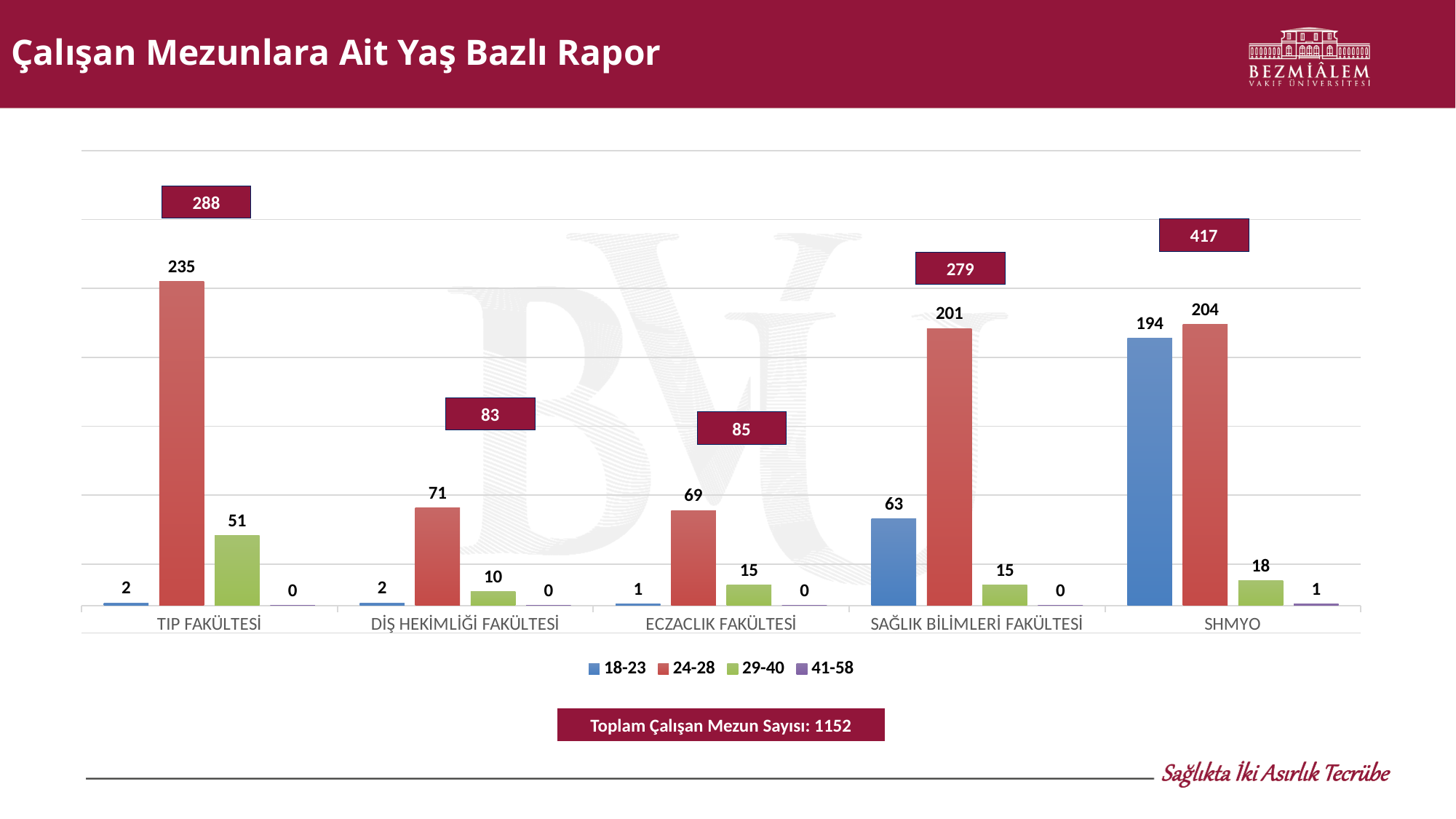
Which category has the highest value for the 24-28 series? TIP FAKÜLTESİ Which category has the lowest value for the 18-23 series? ECZACLIK FAKÜLTESİ What kind of chart is shown on the slide? bar chart What total is shown in the box above the SHMYO group? 417 What is the difference between the 24-28 values for SAĞLIK BİLİMLERİ FAKÜLTESİ and ECZACLIK FAKÜLTESİ? 132 What is the value for the 18-23 series at SHMYO? 194 What is the value for the 41-58 series at SHMYO? 1 What is the value for the 24-28 series at TIP FAKÜLTESİ? 235 How many series does the legend list? 4 Which is larger: the 29-40 value for TIP FAKÜLTESİ or the 29-40 value for SHMYO? TIP FAKÜLTESİ How many categories are shown on the x axis? 5 What is the value for the 29-40 series at DİŞ HEKİMLİĞİ FAKÜLTESİ? 10